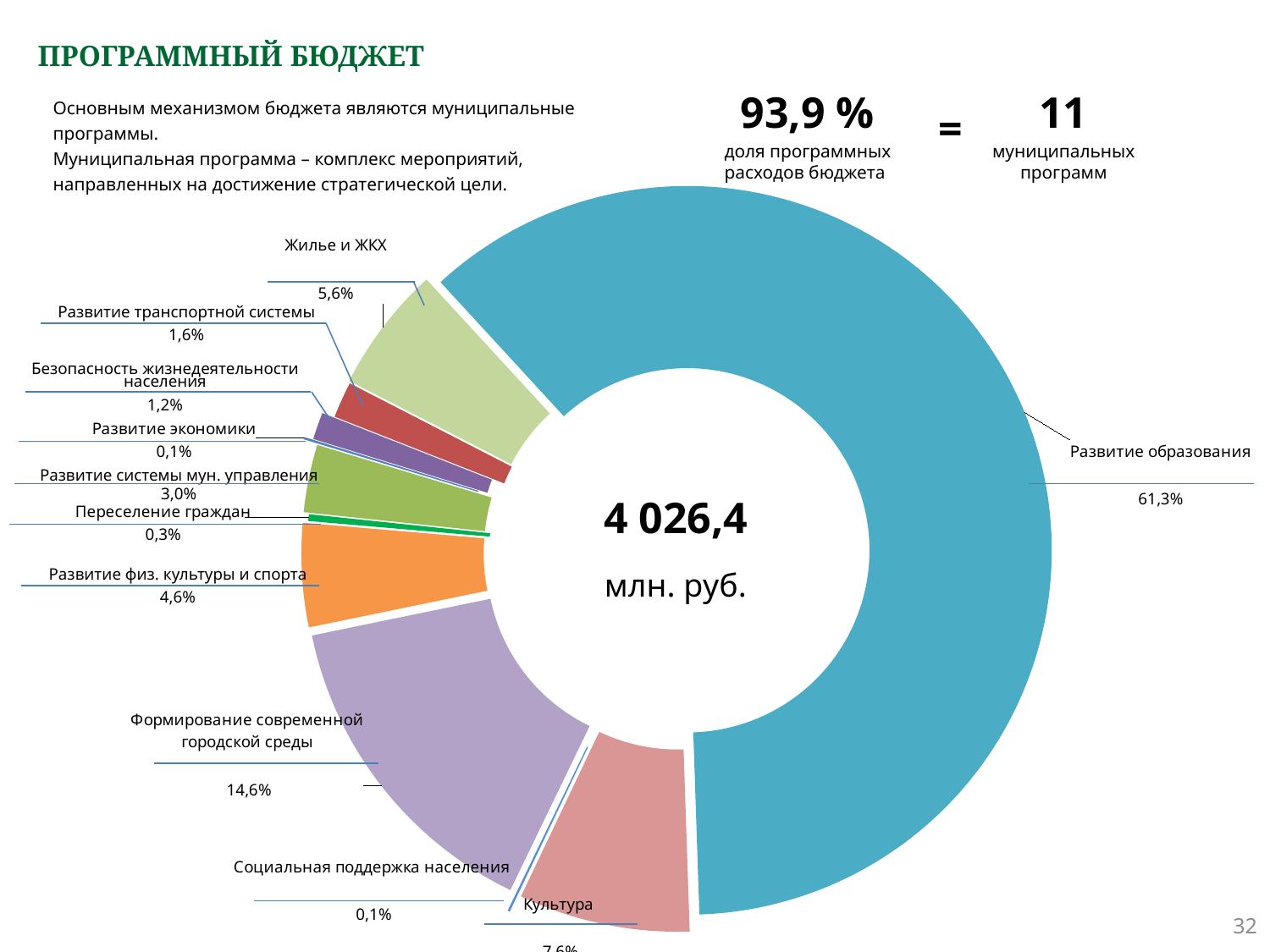
What is the value shown for Развитие физ. культуры и спорта? 4,6% What kind of chart is shown on the slide? Pie chart (donut) Which category has the largest share of the pie chart? Развитие образования What is the value shown for Формирование современной городской среды? 14,6% What is the value shown for Развитие системы мун. управления? 3,0% What total value is printed in the centre of the chart? 4 026,4 млн. руб. Which is larger, Жилье и ЖКХ or Развитие транспортной системы? Жилье и ЖКХ What share of the pie chart does Развитие образования account for? 61,3% What is the value shown for Жилье и ЖКХ? 5,6% What is the difference between the shares of Развитие образования and Формирование современной городской среды? 46,7% How many categories are shown in the pie chart? 11 What is the difference between the shares of Жилье и ЖКХ and Развитие физ. культуры и спорта? 1,0%